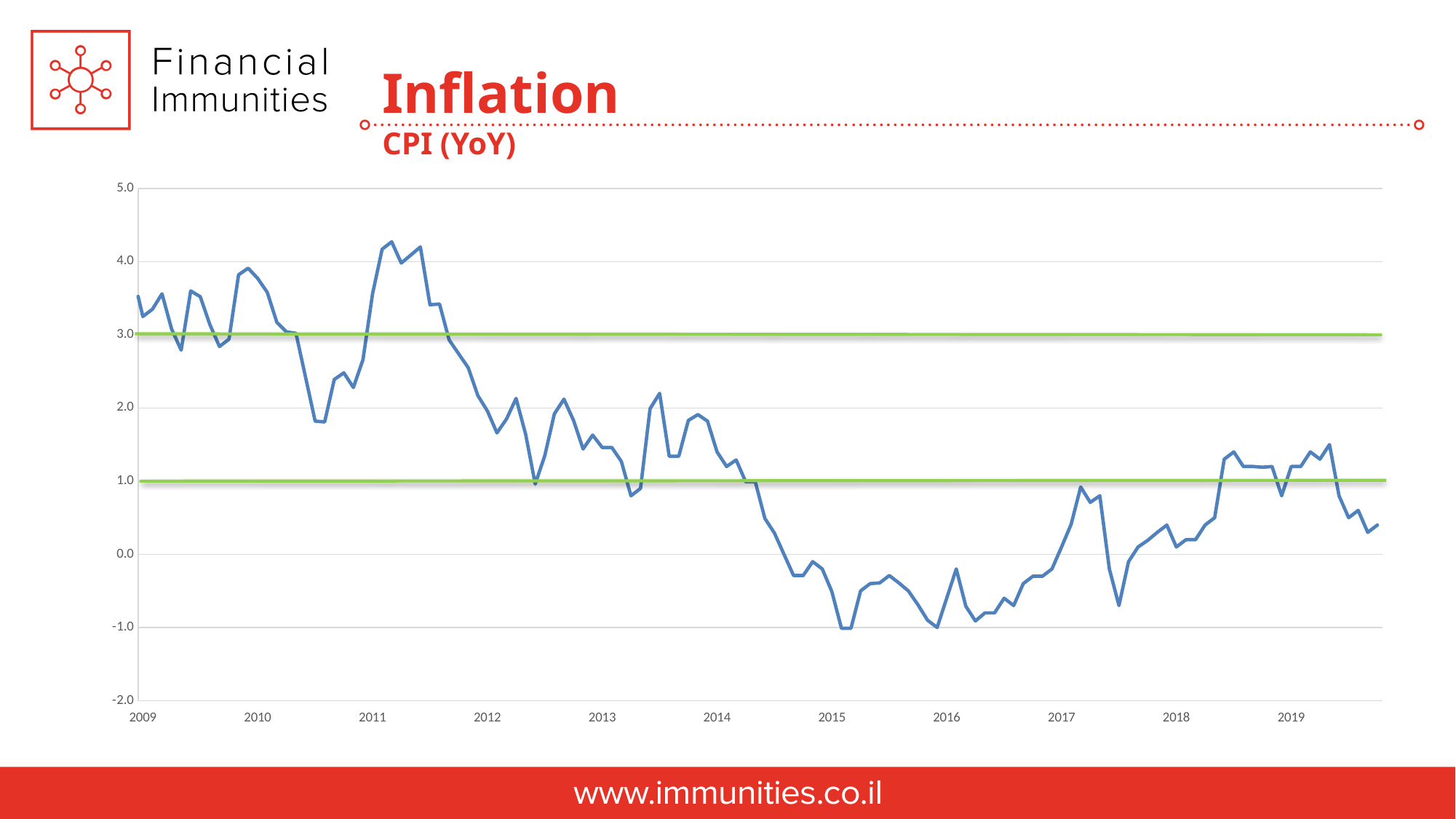
Is the CPI value at the start of 2018 greater or less than 1.0? less Is the CPI value at the start of 2015 greater or less than 0.0? less At what value on the y axis is the lower green horizontal line drawn? 1.0 What is the title of the chart? CPI (YoY) Is the CPI value at the start of 2009 greater or less than 3.0? greater Overall, does the CPI line rise or fall from 2009 to 2019? fall What kind of chart is shown on the slide? line chart Which is larger, the CPI value at the start of 2009 or at the start of 2019? 2009 How many year labels are shown on the x axis? 11 At what value on the y axis is the upper green horizontal line drawn? 3.0